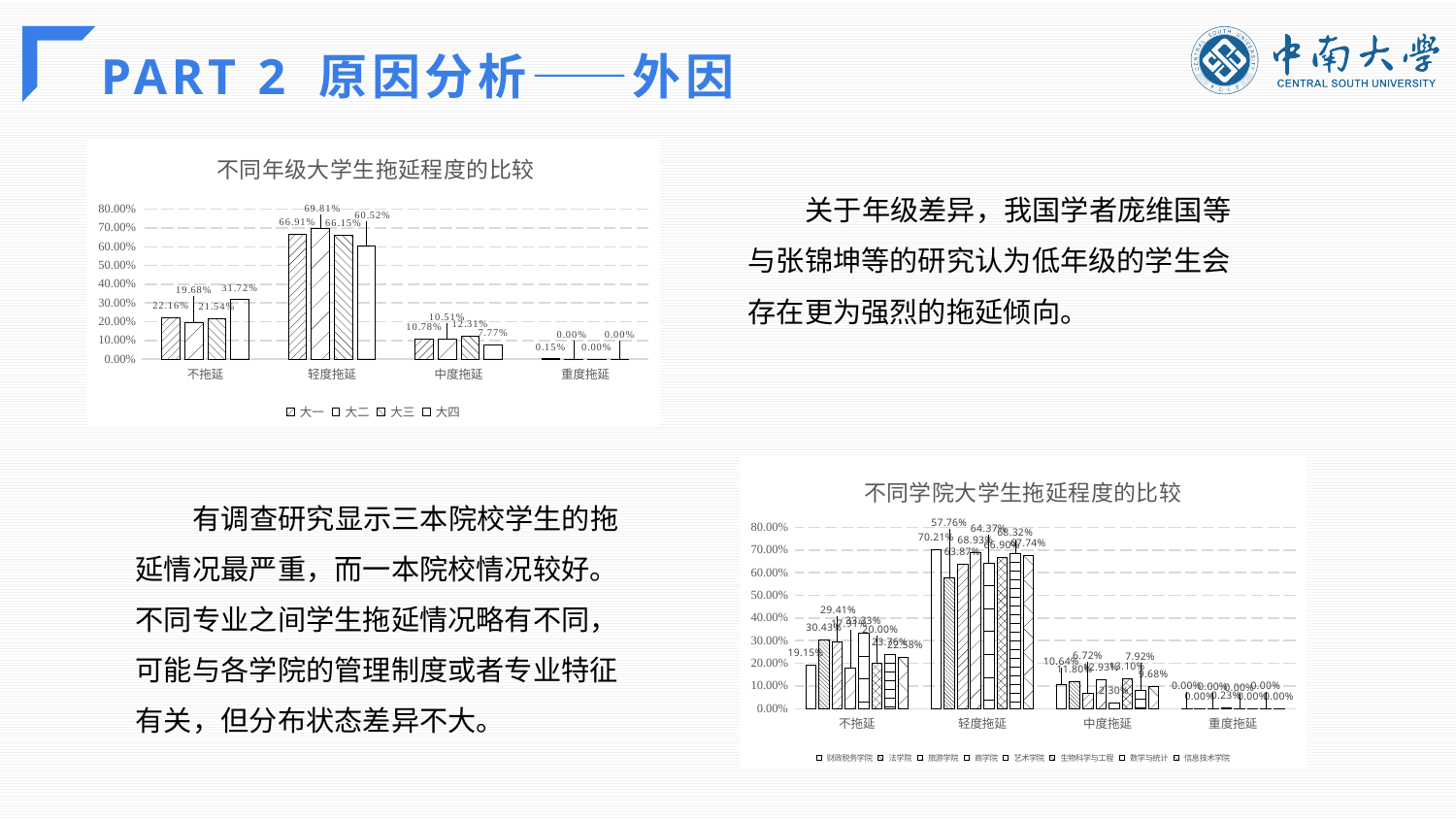
In the chart "不同年级大学生拖延程度的比较", which is larger in the 中度拖延 category, 大三 or 大四? 大三 What kind of chart is "不同年级大学生拖延程度的比较"? bar chart In the chart "不同学院大学生拖延程度的比较", how many categories are shown on the x axis? 4 In the chart "不同年级大学生拖延程度的比较", how many series does the legend list? 4 In the chart "不同年级大学生拖延程度的比较", what is the value for 大一 in the 重度拖延 category? 0.15% In the chart "不同年级大学生拖延程度的比较", what is the difference between 大一 and 大二 in the 不拖延 category? 2.48% In the chart "不同年级大学生拖延程度的比较", which grade has the highest value in the 不拖延 category? 大四 In the chart "不同学院大学生拖延程度的比较", how many series does the legend list? 8 In the chart "不同年级大学生拖延程度的比较", is the value for 大一 in 轻度拖延 greater or less than 60.00%? greater In the chart "不同年级大学生拖延程度的比较", what is the value for 大四 in the 不拖延 category? 31.72% In the chart "不同年级大学生拖延程度的比较", what is the value for 大二 in the 轻度拖延 category? 69.81% In the chart "不同年级大学生拖延程度的比较", which grade has the lowest value in the 轻度拖延 category? 大四